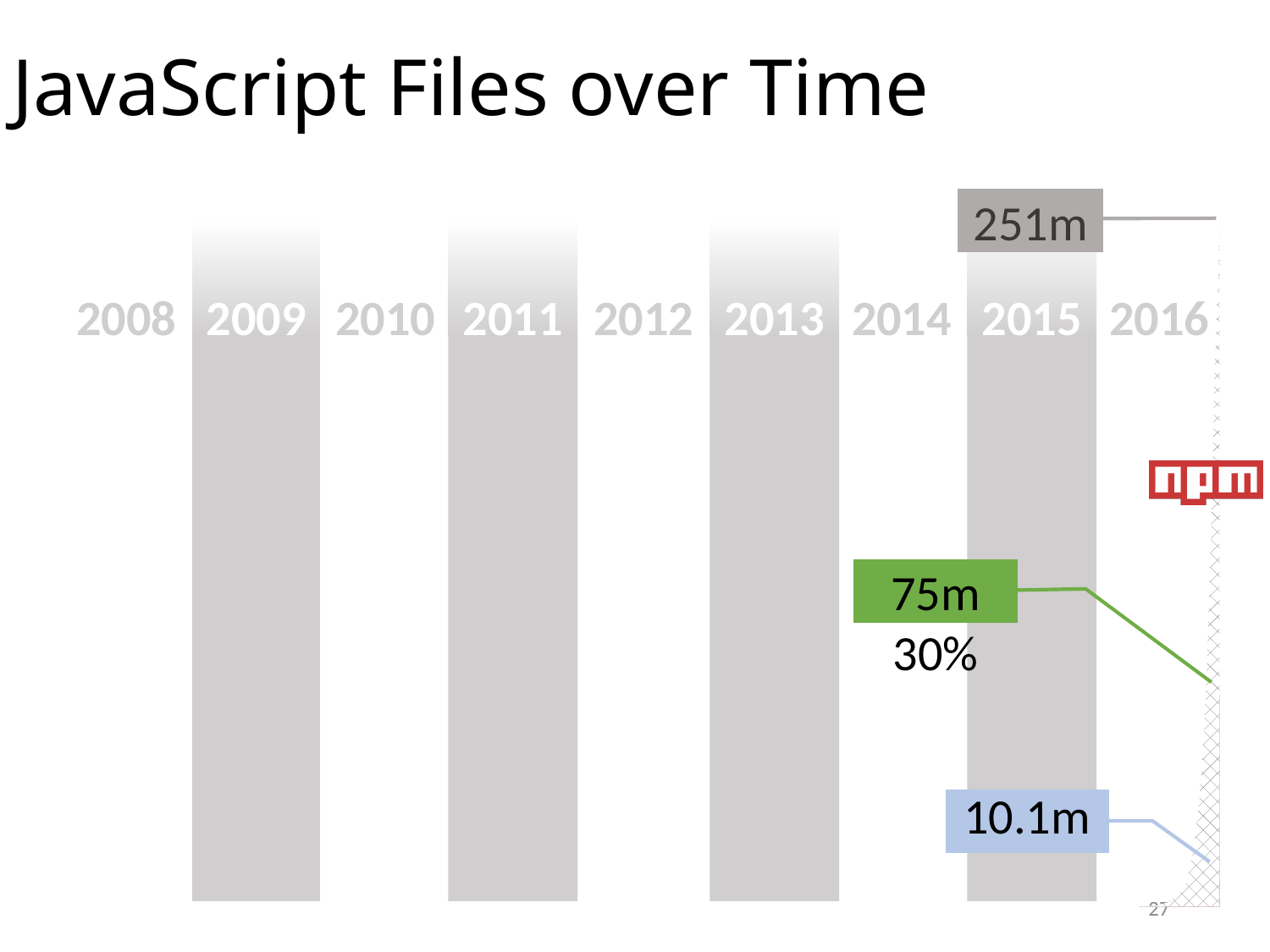
What is the first year labelled on the x axis? 2008 What value is shown in the blue callout label? 10.1m What value is shown in the green callout label? 75m What percentage is printed below the green 75m label? 30% What is the title of the chart? JavaScript Files over Time What is the difference between the 251m value and the 75m value? 176m What is the last year labelled on the x axis? 2016 What value is shown in the gray callout label at the top of the chart? 251m Which of the three labelled values is the smallest? 10.1m Is the green labelled value (75m) larger or smaller than the blue labelled value (10.1m)? larger Which of the three labelled values is the largest? 251m How many years are labelled along the x axis of the chart? 9